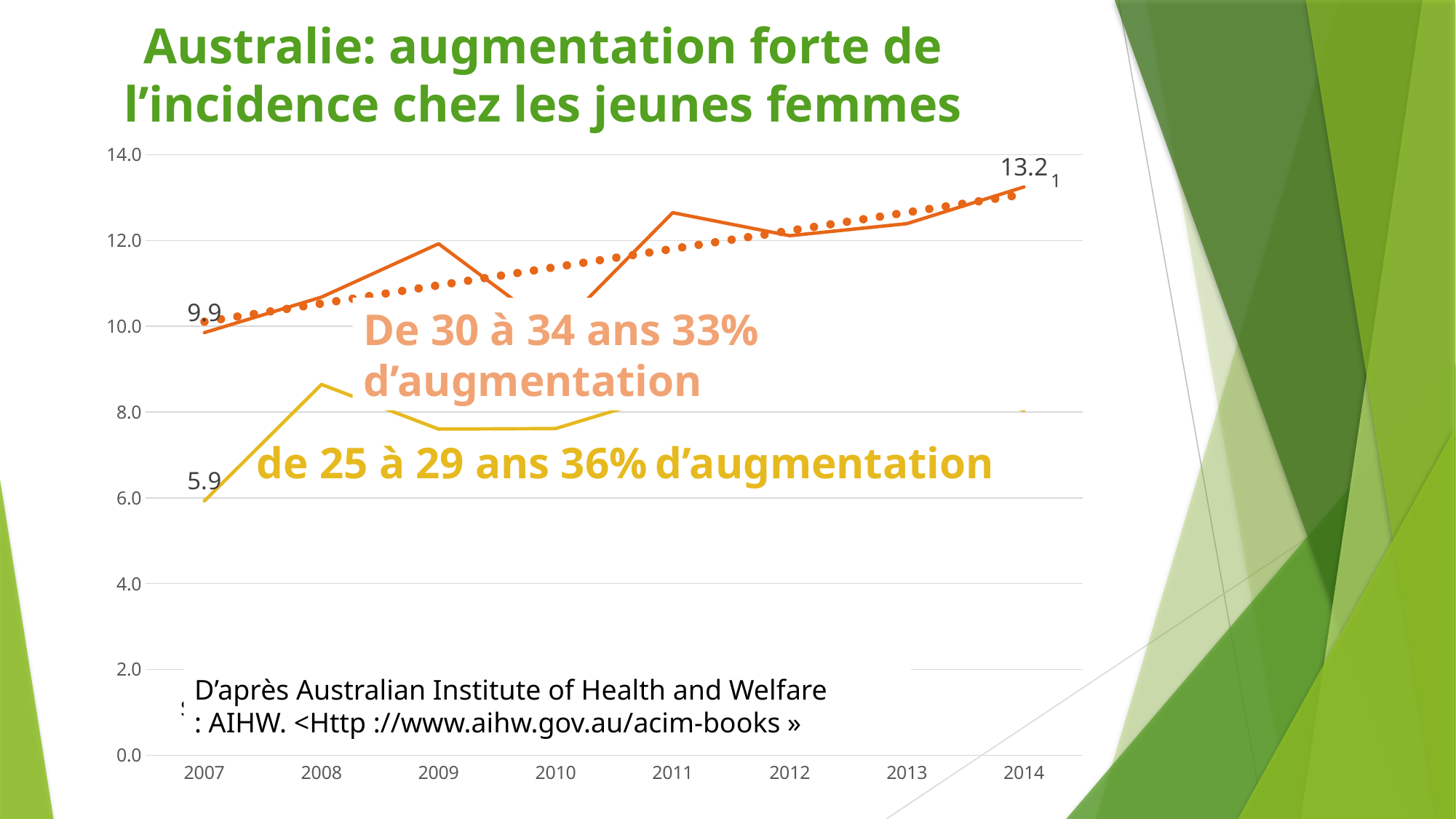
In 2007, which line has the larger value, the orange line or the yellow line? the orange line Is the value of the yellow line in 2009 greater or less than 8.0? less Is the value of the orange line in 2011 greater or less than 12.0? greater Does the orange line rise or fall overall from 2007 to 2014? rise Is the value of the yellow line in 2008 greater or less than 8.0? greater What is the difference between the orange line's 2014 value and its 2007 value? 3.3 What is the value shown for the orange line (30 à 34 ans) in 2007? 9.9 What kind of chart is shown on the slide? line chart In which year does the orange line reach its highest value? 2014 What is the value shown for the yellow line (25 à 29 ans) in 2007? 5.9 What is the value shown for the orange line (30 à 34 ans) in 2014? 13.2 How many years are shown on the x axis? 8